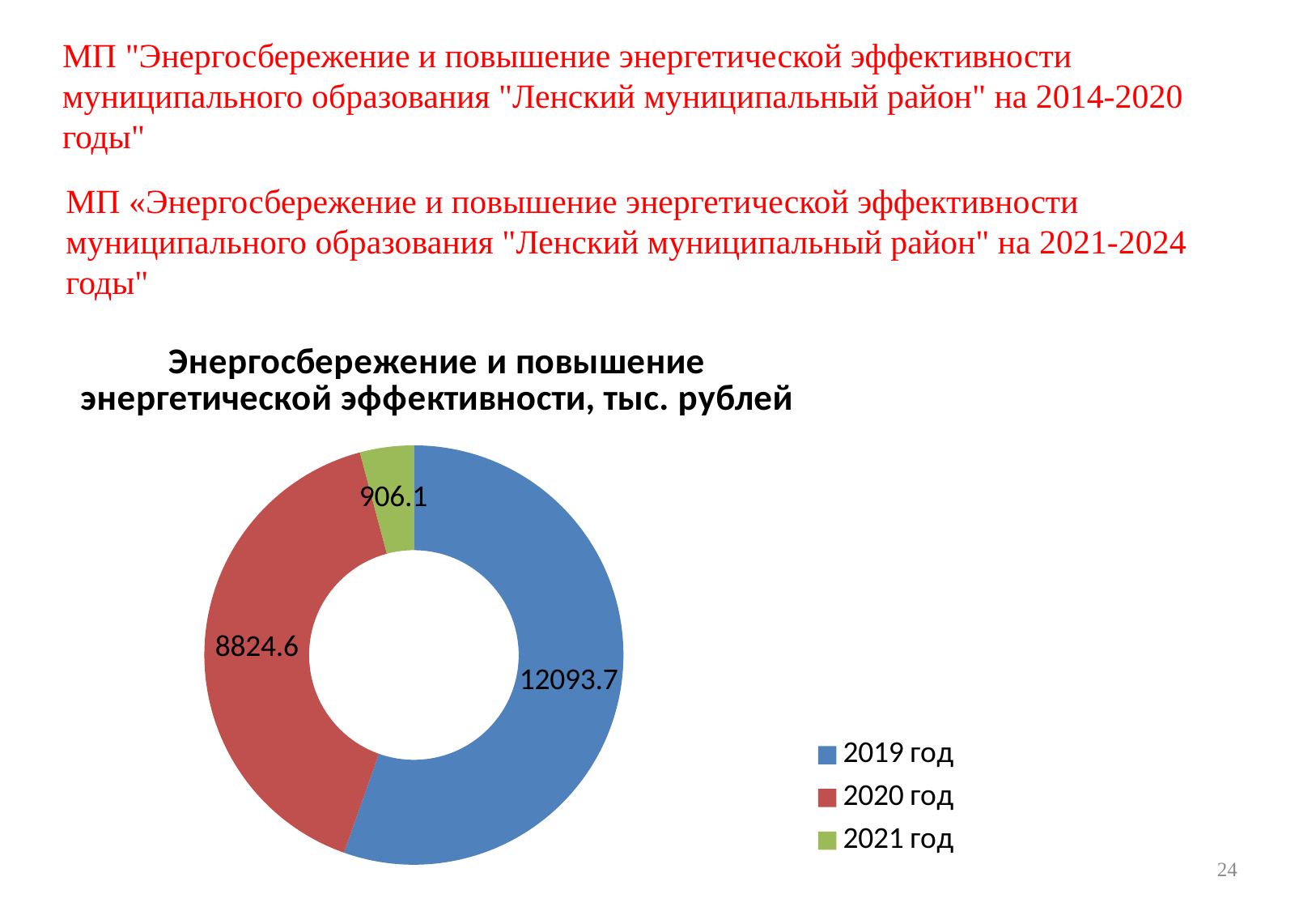
How many entries does the legend list? 3 What is the difference between the values for 2020 год and 2021 год? 7918.5 What is the difference between the values for 2019 год and 2020 год? 3269.1 What is the value for 2019 год in the chart? 12093.7 What is the title of the chart? Энергосбережение и повышение энергетической эффективности, тыс. рублей Which is larger, the value for 2020 год or the value for 2021 год? 2020 год Which year has the largest value in the chart? 2019 год How many slices does the chart have? 3 Which year has the smallest value in the chart? 2021 год What kind of chart is shown on the slide? doughnut chart What is the value for 2021 год in the chart? 906.1 What is the value for 2020 год in the chart? 8824.6